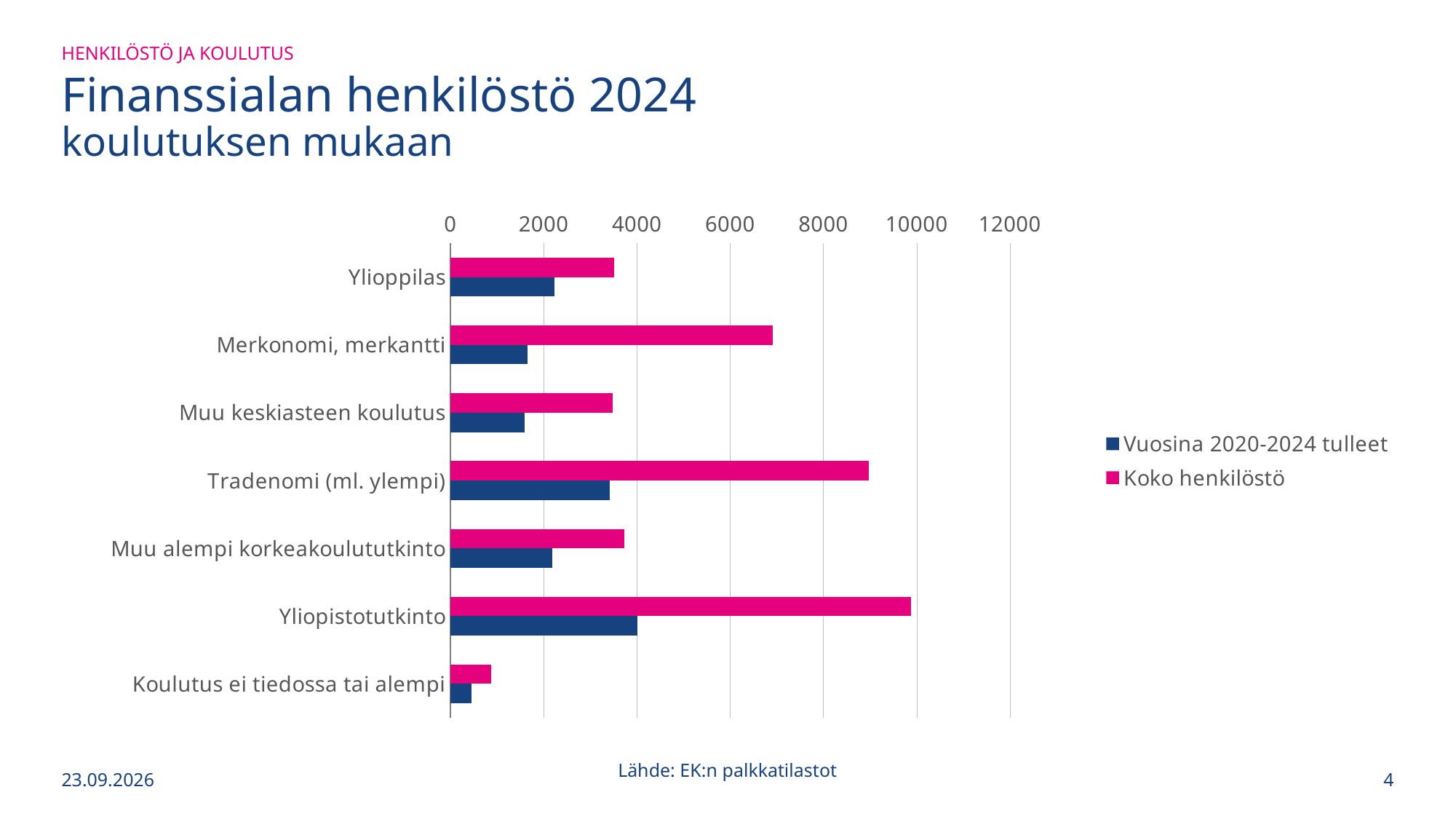
Which category has the lowest value for Koko henkilöstö? Koulutus ei tiedossa tai alempi Which category has the highest value for Vuosina 2020-2024 tulleet? Yliopistotutkinto For Koko henkilöstö, which is larger: Merkonomi, merkantti or Ylioppilas? Merkonomi, merkantti What kind of chart is shown on the slide? bar chart How many series does the legend list? 2 Is the Vuosina 2020-2024 tulleet value for Merkonomi, merkantti greater or less than 2000? less Which category has the highest value for Koko henkilöstö? Yliopistotutkinto Is the Koko henkilöstö value for Koulutus ei tiedossa tai alempi greater or less than 2000? less Is the Koko henkilöstö value for Merkonomi, merkantti greater or less than 6000? greater How many education categories are shown on the chart? 7 Which series is shown in pink in the legend? Koko henkilöstö